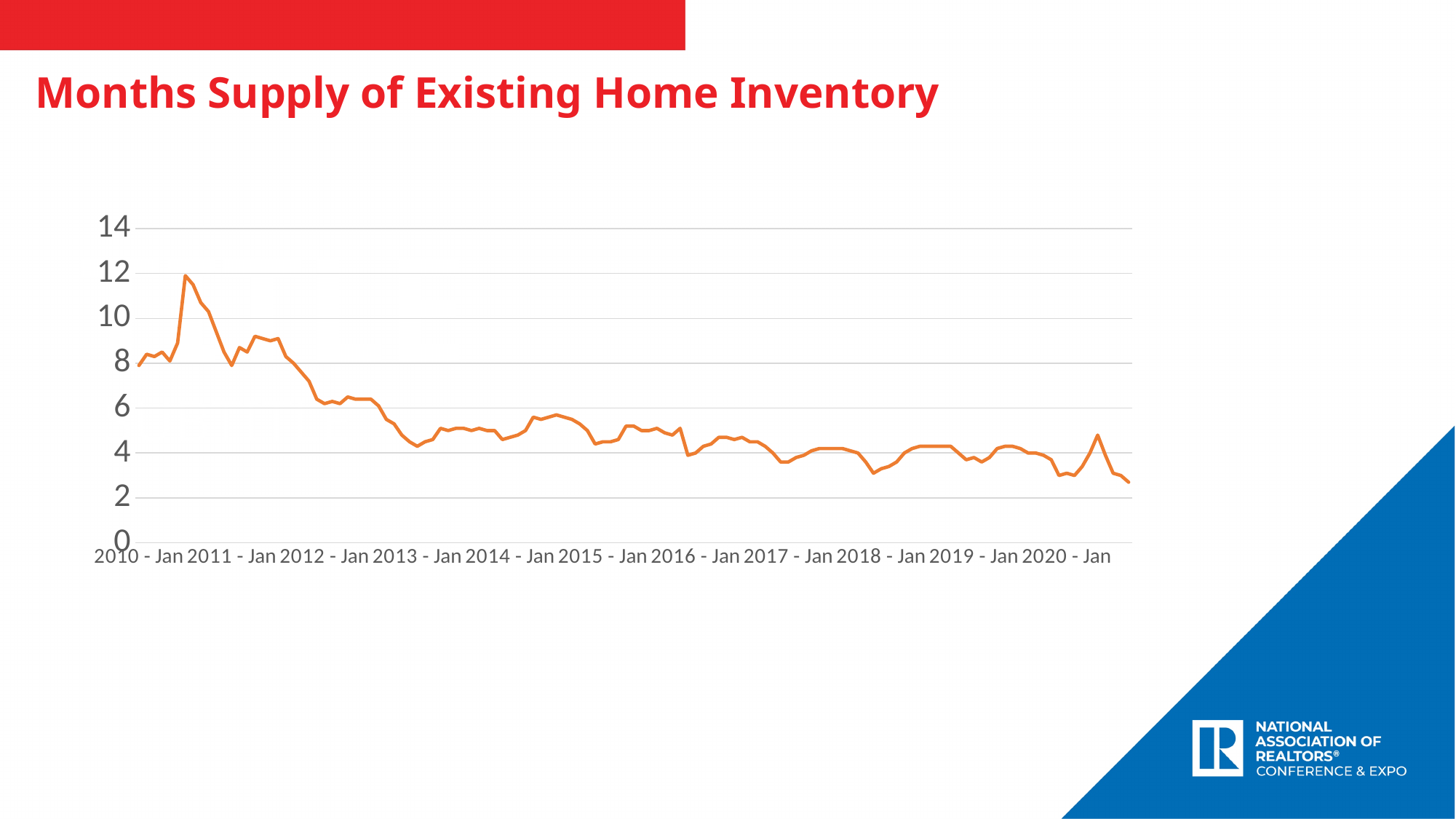
Is the value at 2020 - Jan greater or less than 4? less How many year labels are shown on the x axis? 11 Which is higher, the value at 2012 - Jan or the value at 2013 - Jan? 2012 - Jan Is the value at 2010 - Jan greater or less than 6? greater Is the highest point on the line greater or less than 10? greater What is the title of the chart? Months Supply of Existing Home Inventory Which is higher, the value at 2010 - Jan or the value at 2020 - Jan? 2010 - Jan What is the highest value shown on the y axis? 14 Overall, do the values rise or fall from 2010 - Jan to 2020 - Jan? fall What kind of chart is shown on the slide? line chart